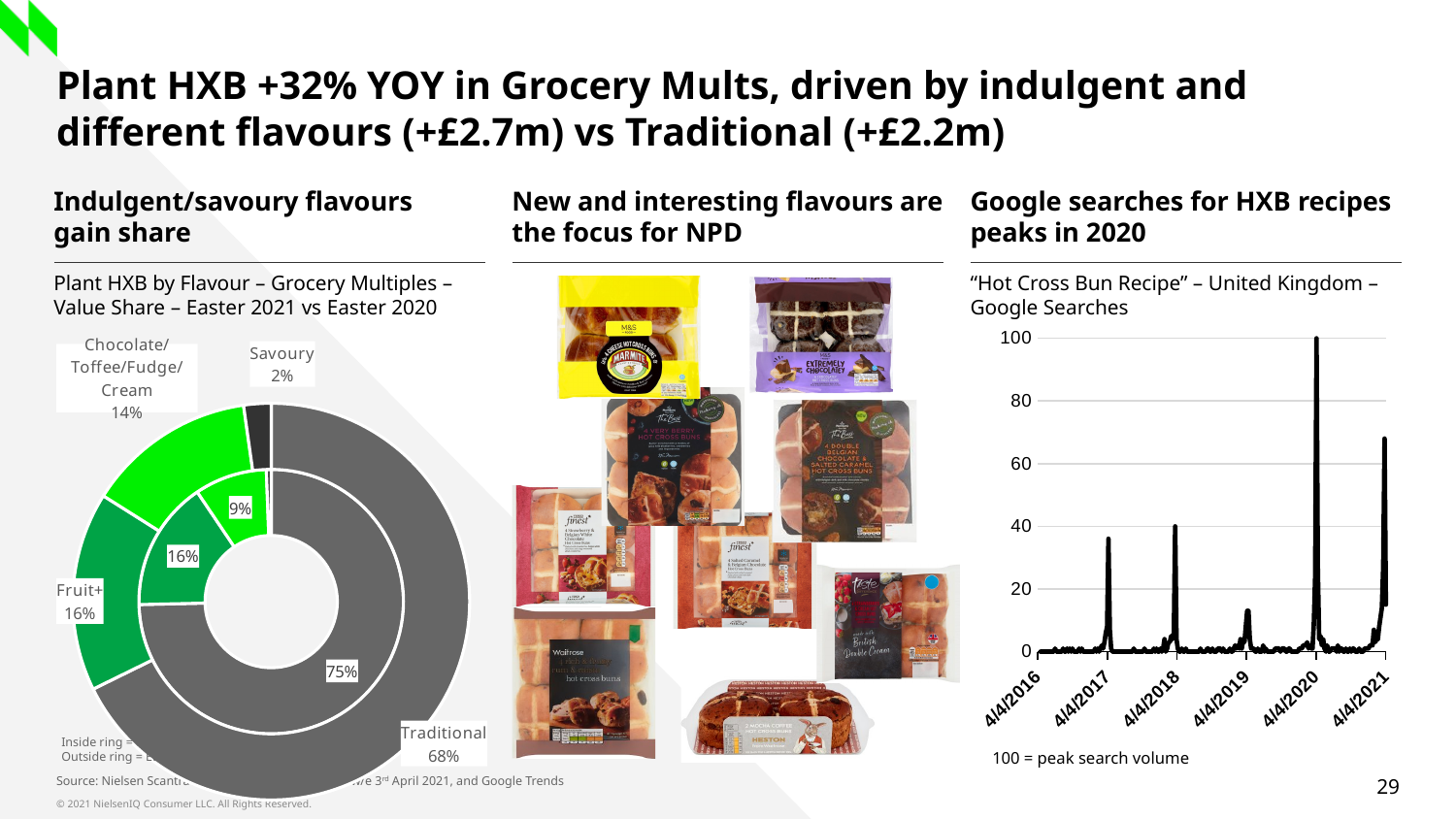
In the 'Plant HXB by Flavour' chart on the left, how many flavour categories are shown? 4 In the 'Plant HXB by Flavour' chart on the left, what kind of chart is used? doughnut chart In the 'Plant HXB by Flavour' chart on the left, what is the difference between the Traditional share on the inner ring (75%) and on the outer ring (68%)? 7 percentage points In the 'Plant HXB by Flavour' chart on the left, what is the value share for Traditional on the outer ring? 68% In the 'Plant HXB by Flavour' chart on the left, which flavour has the smallest share on the outer ring? Savoury In the 'Plant HXB by Flavour' chart on the left, what is the value share for Chocolate/Toffee/Fudge/Cream on the outer ring? 14% In the 'Plant HXB by Flavour' chart on the left, what is the value share for Savoury on the outer ring? 2% In the 'Plant HXB by Flavour' chart on the left, what is the largest value shown on the inner ring? 75% In the 'Plant HXB by Flavour' chart on the left, what is the value share for Fruit+ on the outer ring? 16% In the 'Hot Cross Bun Recipe' Google Searches chart on the right, is the peak near 4/4/2019 greater or less than 20? less In the 'Hot Cross Bun Recipe' Google Searches chart on the right, is the peak near 4/4/2021 greater or less than 60? greater In the 'Hot Cross Bun Recipe' Google Searches chart on the right, what kind of chart is used? line chart